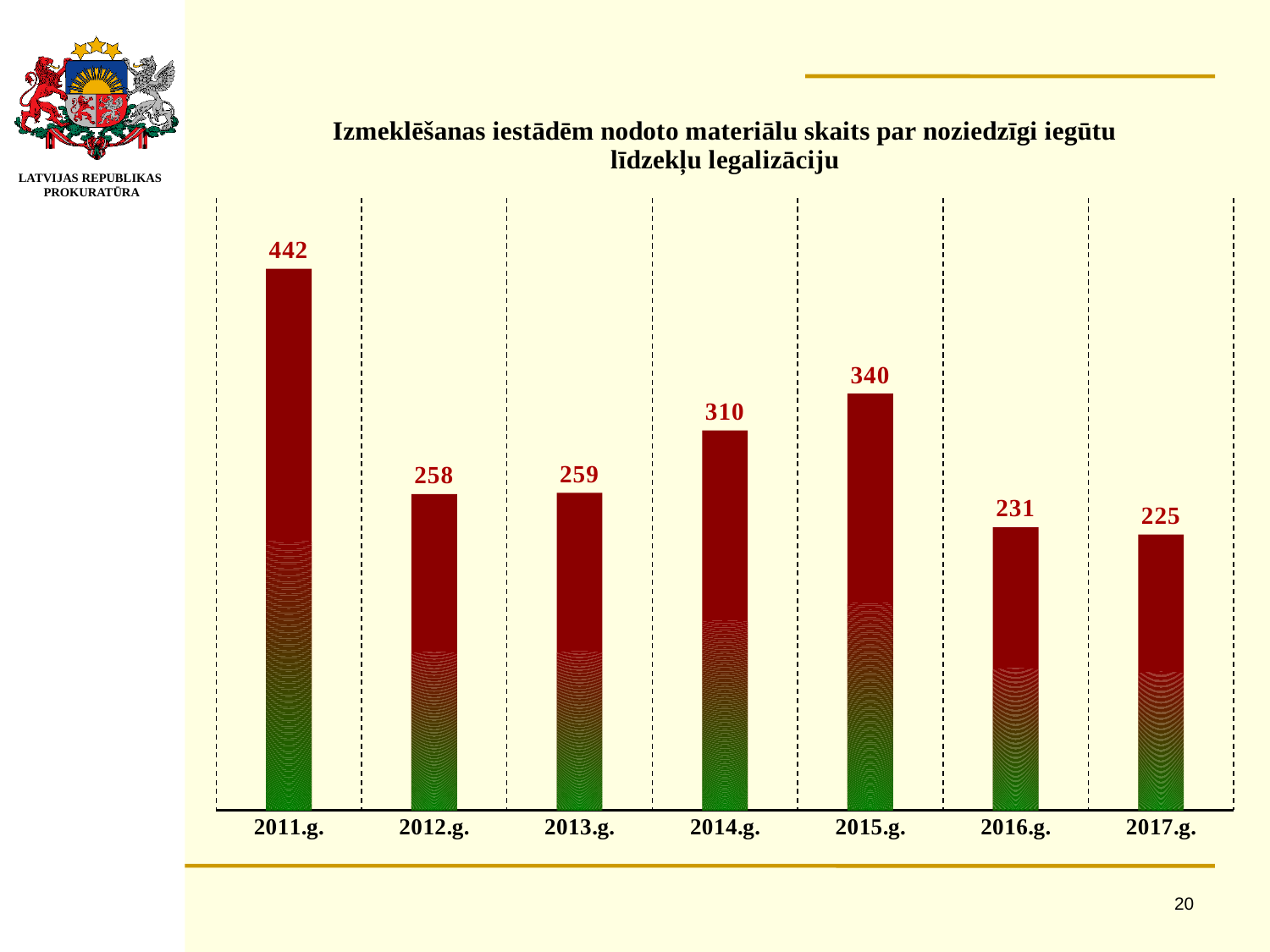
What is the difference between the values for 2015.g. and 2016.g.? 109 Do the values rise or fall from 2015.g. to 2017.g.? fall What is the title of the chart? Izmeklēšanas iestādēm nodoto materiālu skaits par noziedzīgi iegūtu līdzekļu legalizāciju Which year has the lowest value? 2017.g. Which year has the highest value? 2011.g. What is the difference between the values for 2011.g. and 2012.g.? 184 What kind of chart is shown on the slide? bar chart How many years are shown on the x axis? 7 What is the value for 2011.g.? 442 What is the value for 2017.g.? 225 Which is larger, the value for 2014.g. or the value for 2015.g.? 2015.g. What is the value for 2014.g.? 310